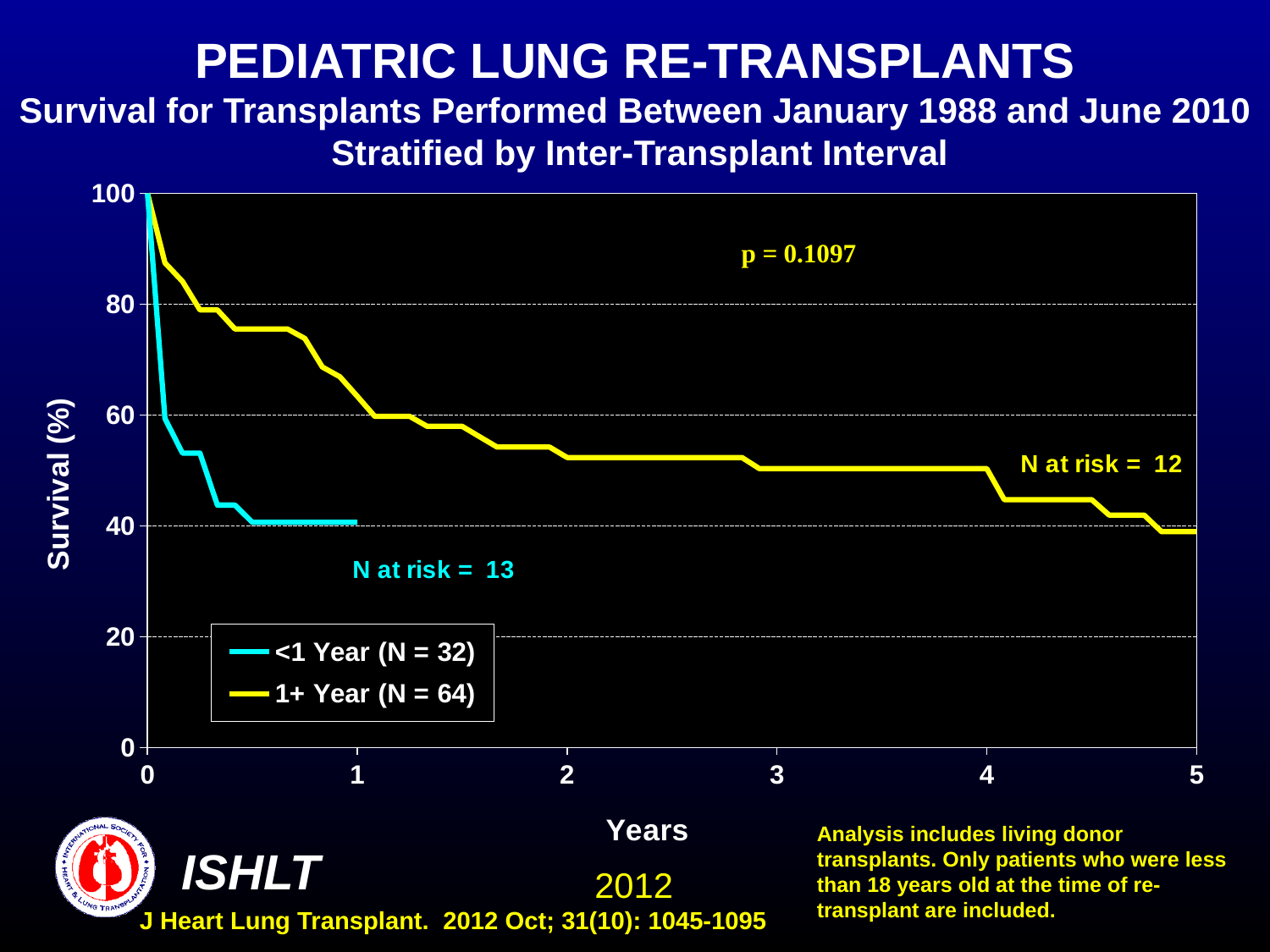
What p-value is printed on the chart? p = 0.1097 Do the survival curves rise or fall as years increase? fall Is the survival for the 1+ Year group at 2 years greater or less than 40? greater What is the number at risk printed next to the 1+ Year curve? 12 What is the N for the <1 Year group shown in the legend? 32 Is the survival for the <1 Year group at 1 year greater or less than 60? less What kind of chart is shown on the slide? line chart How many series does the legend list? 2 What is the label of the y axis? Survival (%) What is the N for the 1+ Year group shown in the legend? 64 What is the number at risk printed next to the <1 Year curve? 13 At 1 year, which group has higher survival, <1 Year or 1+ Year? 1+ Year